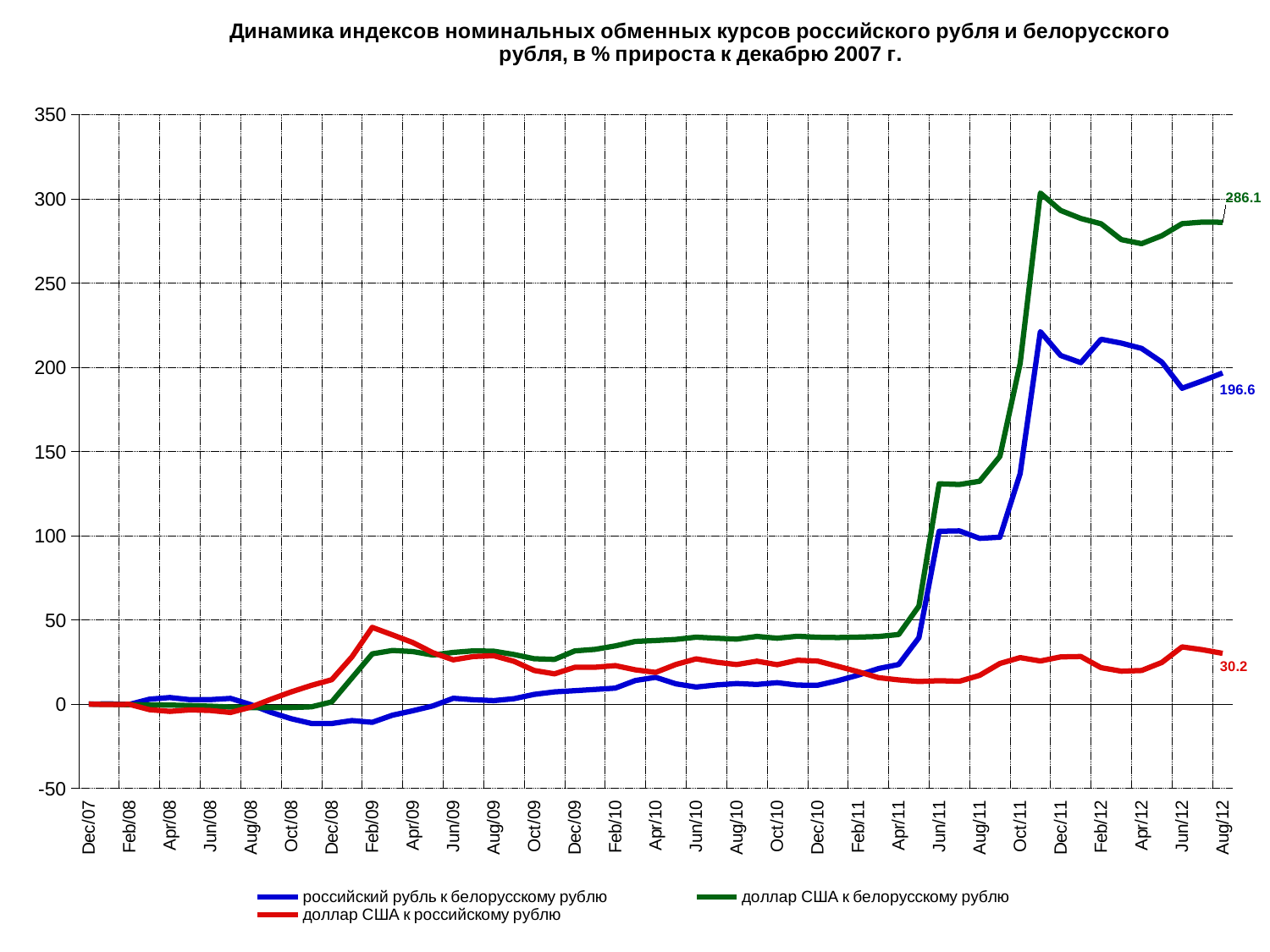
Which series has the highest value at Aug/12? доллар США к белорусскому рублю What is the value for "доллар США к белорусскому рублю" at Aug/12? 286.1 What is the value for "доллар США к российскому рублю" at Aug/12? 30.2 What is the difference between the Aug/12 values of "доллар США к белорусскому рублю" and "российский рубль к белорусскому рублю"? 89.5 What kind of chart is shown on the slide? line chart Which colour is used for the "доллар США к российскому рублю" series? red Is the value for "российский рубль к белорусскому рублю" at Dec/10 greater or less than 50? less How many series does the legend list? 3 At Aug/12, which is larger: the value for "российский рубль к белорусскому рублю" or the value for "доллар США к российскому рублю"? российский рубль к белорусскому рублю Is the value for "доллар США к белорусскому рублю" at Jun/11 greater or less than 100? greater Which series has the lowest value at Aug/12? доллар США к российскому рублю What is the value for "российский рубль к белорусскому рублю" at Aug/12? 196.6